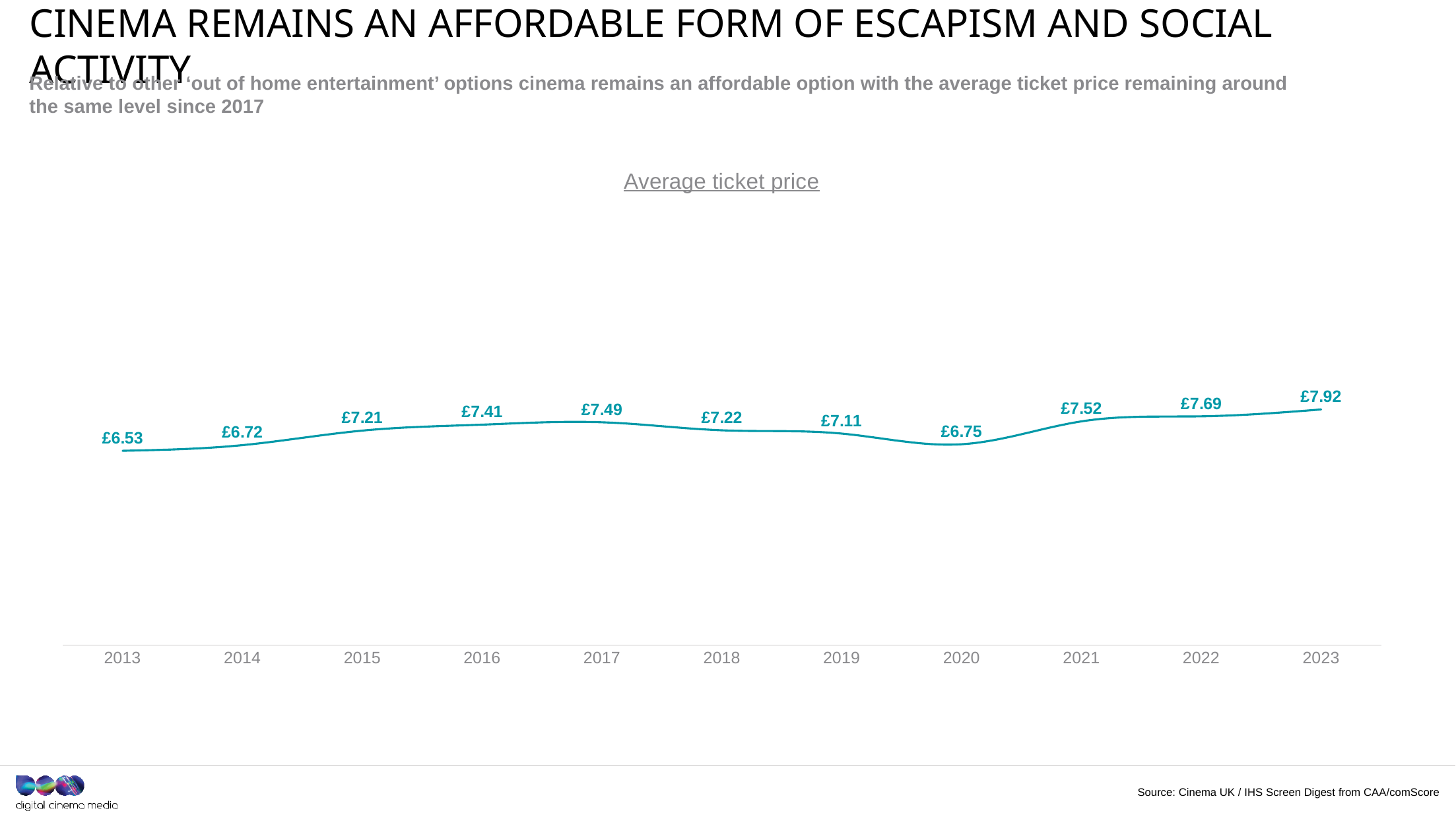
What is the difference between the average ticket price in 2023 and in 2013? £1.39 Which year has the highest average ticket price? 2023 Which year has the lowest average ticket price? 2013 What kind of chart is shown on the slide? Line chart Did the average ticket price rise or fall between 2017 and 2020? Fall What is the title of the chart? Average ticket price What was the average ticket price in 2017? £7.49 What is the difference between the average ticket price in 2017 and in 2020? £0.74 What was the average ticket price in 2020? £6.75 Which year had a higher average ticket price, 2016 or 2019? 2016 How many years are plotted on the chart? 11 What was the average ticket price in 2013? £6.53